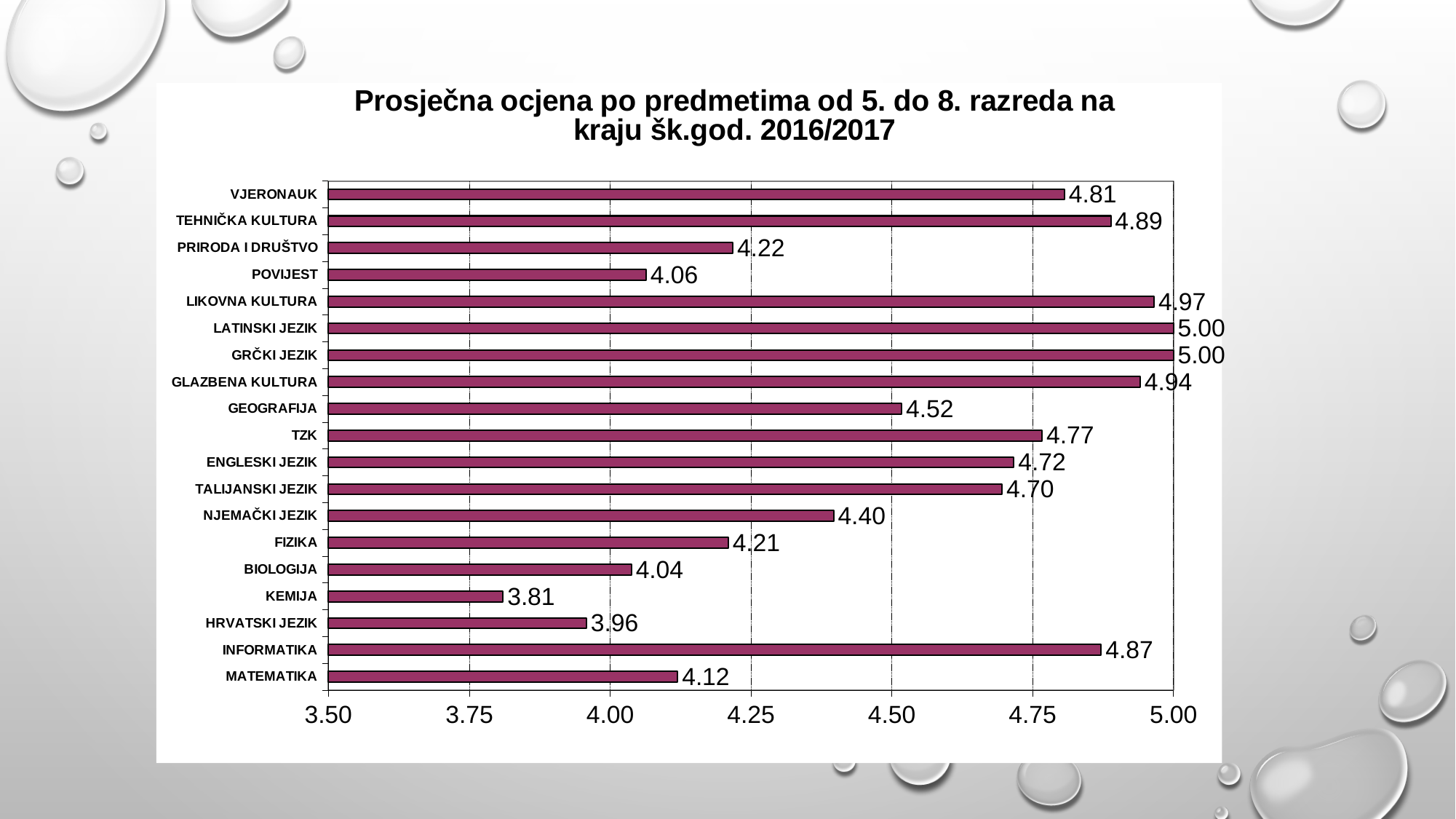
Which subject has the lowest average grade? KEMIJA What is the difference between the values for TEHNIČKA KULTURA and POVIJEST? 0.83 Which has a higher value, GEOGRAFIJA or FIZIKA? GEOGRAFIJA What kind of chart is shown on the slide? bar chart What is the value shown for INFORMATIKA? 4.87 What is the value shown for NJEMAČKI JEZIK? 4.40 What is the average grade shown for MATEMATIKA? 4.12 Which has a higher value, HRVATSKI JEZIK or BIOLOGIJA? BIOLOGIJA What is the value shown for GLAZBENA KULTURA? 4.94 What is the title of the chart? Prosječna ocjena po predmetima od 5. do 8. razreda na kraju šk.god. 2016/2017 How many subjects are shown in the chart? 19 Is the value for TZK greater or less than 4.50? greater